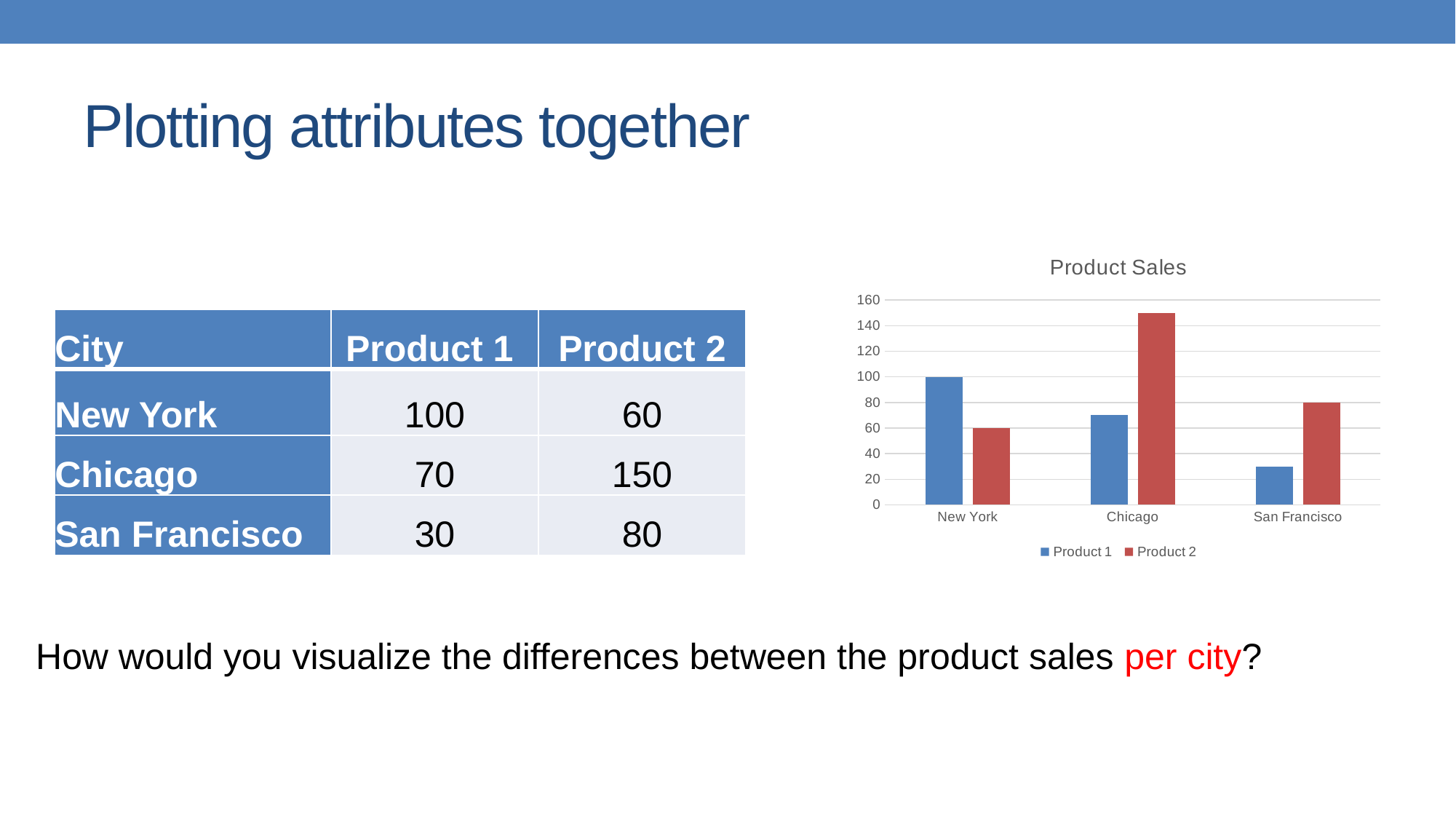
In the Product Sales chart, which is larger for New York: Product 1 or Product 2? Product 1 What is the Product 1 value for New York in the Product Sales chart? 100 Which city has the lowest Product 1 value in the Product Sales chart? San Francisco How many cities are shown on the x axis of the Product Sales chart? 3 What colour are the Product 2 bars in the Product Sales chart? red What kind of chart is the Product Sales chart? bar chart Which city has the highest Product 2 value in the Product Sales chart? Chicago How many series does the legend of the Product Sales chart list? 2 What is the Product 1 value for San Francisco in the Product Sales chart? 30 What is the Product 2 value for Chicago in the Product Sales chart? 150 In the Product Sales chart, what is the difference between Product 2 and Product 1 for Chicago? 80 Is the Product 2 value for Chicago in the Product Sales chart greater or less than 140? greater